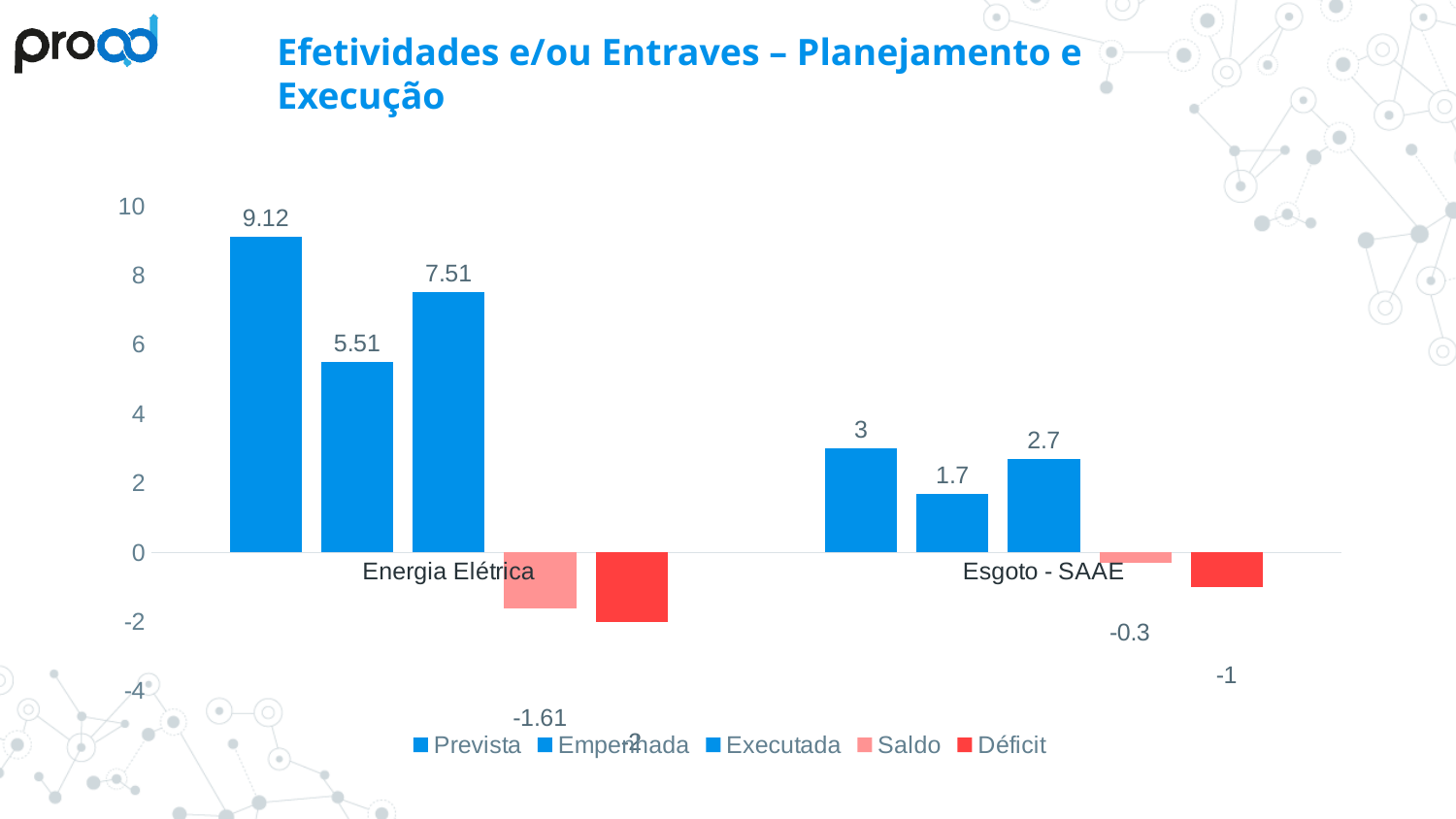
Which category has the higher Prevista value, Energia Elétrica or Esgoto - SAAE? Energia Elétrica What is the difference between the Executada and Empenhada values for Esgoto - SAAE? 1 What is the Executada value for Energia Elétrica? 7.51 Is the Déficit value for Energia Elétrica greater or less than -1? less What kind of chart is shown on the slide? bar chart What is the Empenhada value for Esgoto - SAAE? 1.7 What is the Saldo value for Esgoto - SAAE? -0.3 What is the Déficit value for Esgoto - SAAE? -1 What is the Prevista value for Energia Elétrica? 9.12 What is the difference between the Prevista and Executada values for Energia Elétrica? 1.61 What is the title of the slide? Efetividades e/ou Entraves – Planejamento e Execução How many series does the legend list? 5